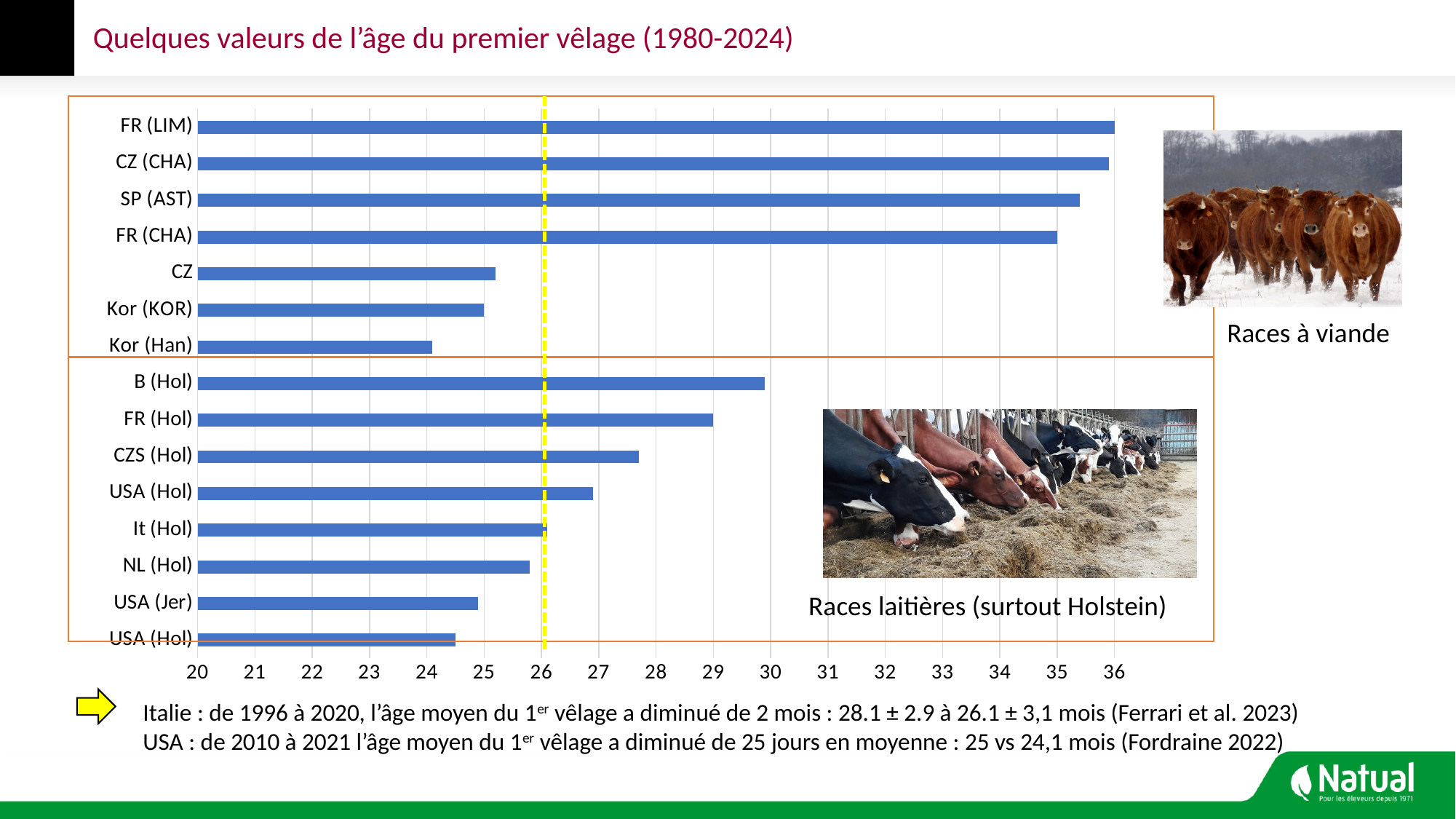
Which has the larger value, FR (CHA) or CZ? FR (CHA) Is the value for USA (Jer) greater or less than 26? less Is the value for CZS (Hol) greater or less than 27? greater Is the value for SP (AST) greater or less than 35? greater At which x-axis value is the yellow dashed vertical line drawn? 26 What is the title of the slide containing the chart? Quelques valeurs de l'âge du premier vêlage (1980-2024) Which has the larger value, B (Hol) or FR (Hol)? B (Hol) What kind of chart is shown on the slide? bar chart Which has the larger value, Kor (KOR) or Kor (Han)? Kor (KOR) How many categories (bars) does the chart show? 15